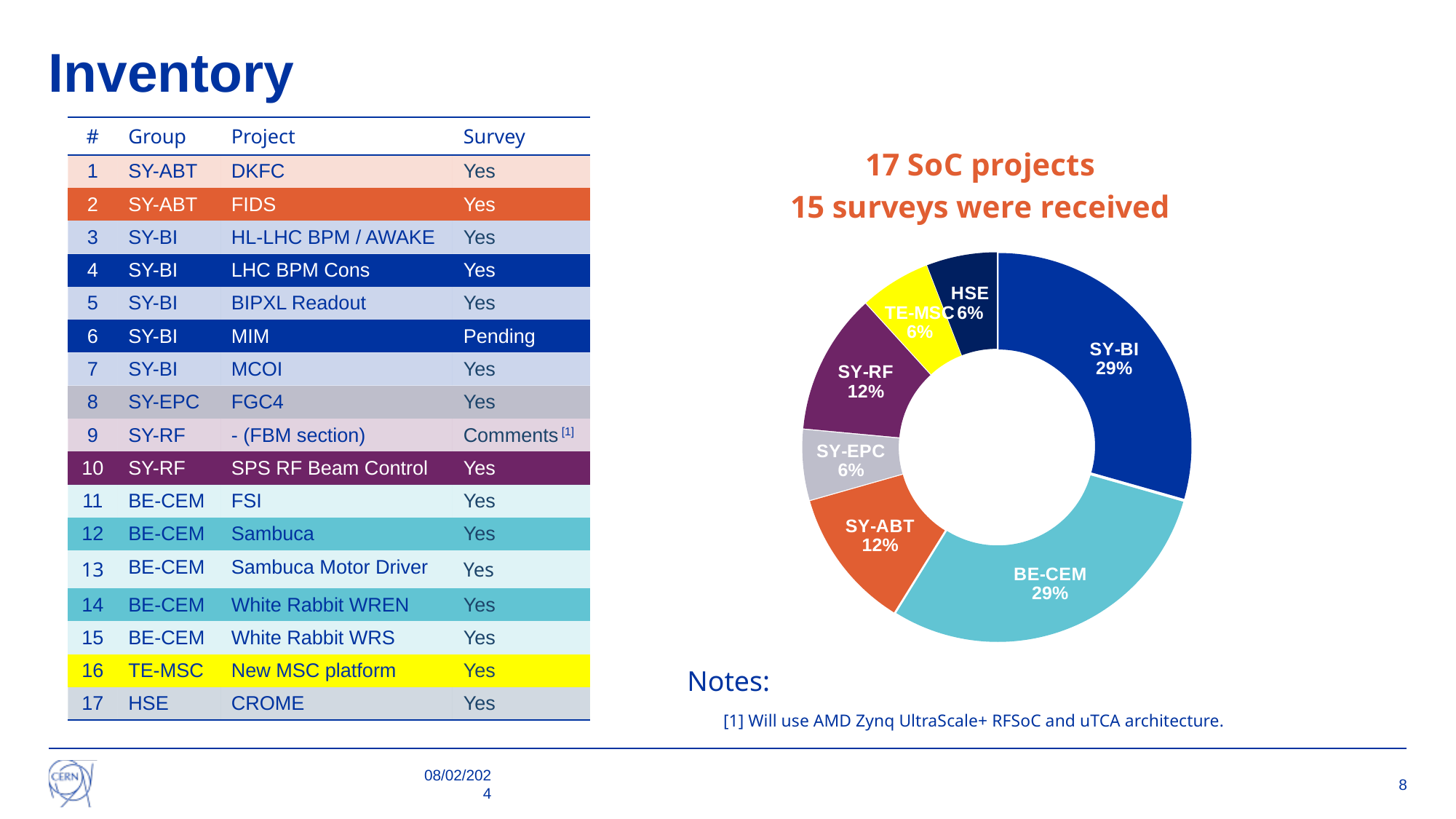
What is the difference in percentage points between BE-CEM and TE-MSC in the doughnut chart? 23% How many groups (slices) are shown in the doughnut chart? 7 Which group is represented by the yellow slice in the doughnut chart? TE-MSC What percentage of SoC projects belongs to SY-BI in the doughnut chart? 29% What share does BE-CEM have in the doughnut chart? 29% What percentage is shown for HSE in the doughnut chart? 6% Which two groups share the largest slice of the doughnut chart? SY-BI and BE-CEM Which has the larger share in the doughnut chart, SY-ABT or SY-EPC? SY-ABT What percentage is shown for SY-EPC in the doughnut chart? 6% What share does SY-RF have in the doughnut chart? 12% What percentage is shown for SY-ABT in the doughnut chart? 12% What kind of chart is shown on the slide? doughnut chart